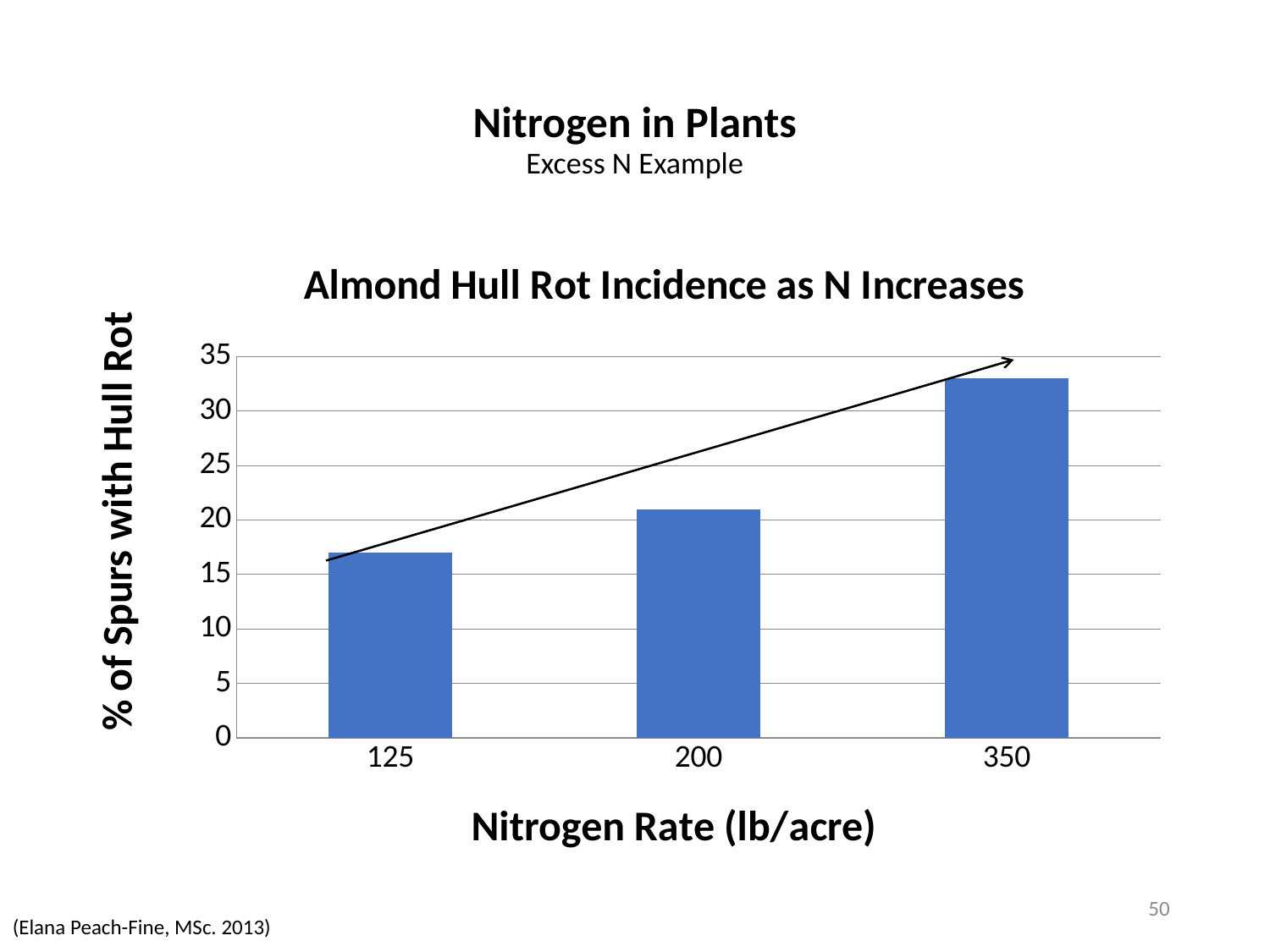
Which has a higher percentage of spurs with hull rot, a nitrogen rate of 125 or 350? 350 Which nitrogen rate has the lowest percentage of spurs with hull rot? 125 Which has a higher percentage of spurs with hull rot, a nitrogen rate of 125 or 200? 200 Is the value for the 125 lb/acre nitrogen rate greater or less than 15? greater Is the value for the 350 lb/acre nitrogen rate greater or less than 30? greater Do the values rise or fall as the nitrogen rate increases along the x axis? rise Is the value for the 200 lb/acre nitrogen rate greater or less than 25? less How many nitrogen rate categories are plotted on the x axis? 3 What kind of chart is shown on the slide? bar chart Which nitrogen rate has the highest percentage of spurs with hull rot? 350 What is the title of the chart? Almond Hull Rot Incidence as N Increases